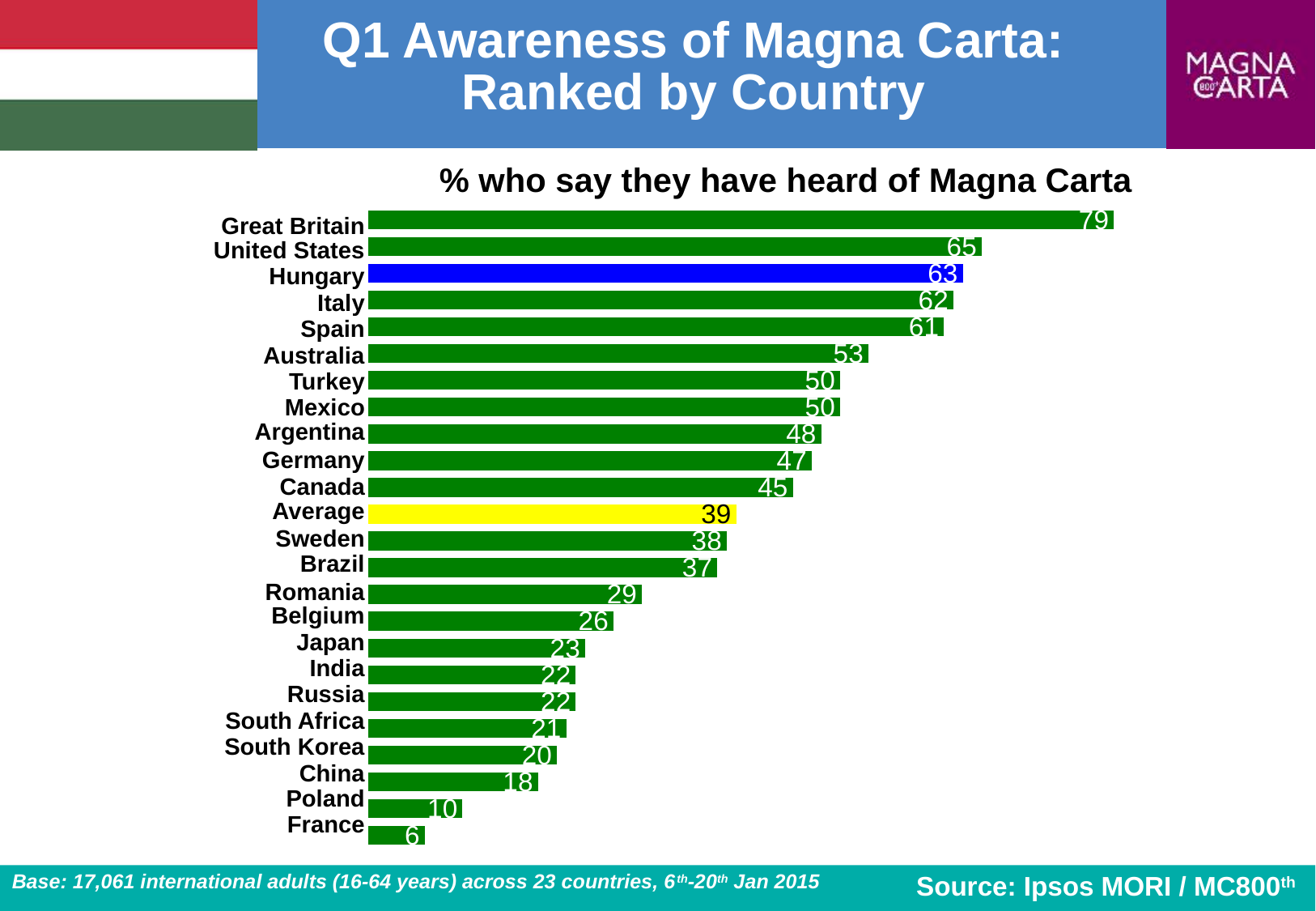
What is the difference between the values for Great Britain and the United States? 14 Which country has the lowest percentage who say they have heard of Magna Carta? France What is the value shown for the Average bar? 39 How many bars are plotted on the chart, including the Average bar? 24 Which country has the highest percentage who say they have heard of Magna Carta? Great Britain Which bar on the chart is coloured blue? Hungary What type of chart is shown on the slide? Bar chart What is the difference between the values for Hungary and the Average? 24 Which has a higher value, Japan or Belgium? Belgium Which has a higher value, Canada or Sweden? Canada What percentage of people in Hungary say they have heard of Magna Carta? 63 What value is shown for Romania? 29